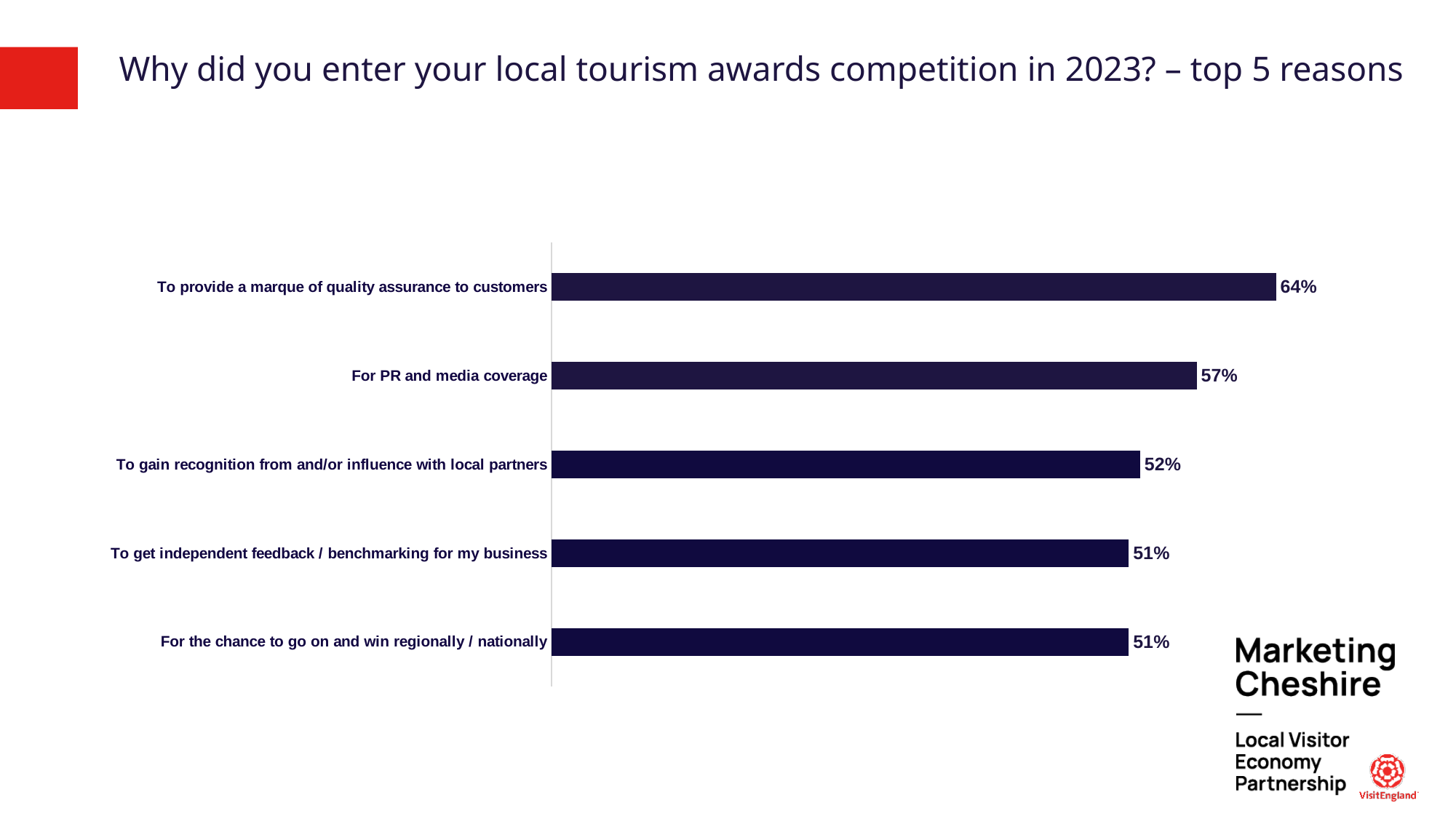
What is the value for 'For PR and media coverage'? 57% What is the value for 'To get independent feedback / benchmarking for my business'? 51% What percentage of respondents entered the awards to provide a marque of quality assurance to customers? 64% What is the difference in percentage points between 'To provide a marque of quality assurance to customers' and 'For PR and media coverage'? 7 percentage points Which two reasons share the same value of 51%? To get independent feedback / benchmarking for my business; For the chance to go on and win regionally / nationally Which reason has the highest percentage? To provide a marque of quality assurance to customers What type of chart is shown on the slide? Bar chart How many reasons are shown in the chart? 5 What percentage entered to gain recognition from and/or influence with local partners? 52% Which is larger: the value for 'For PR and media coverage' or for 'To gain recognition from and/or influence with local partners'? For PR and media coverage What is the title of the slide? Why did you enter your local tourism awards competition in 2023? – top 5 reasons What is the difference between 'For PR and media coverage' and 'For the chance to go on and win regionally / nationally'? 6 percentage points